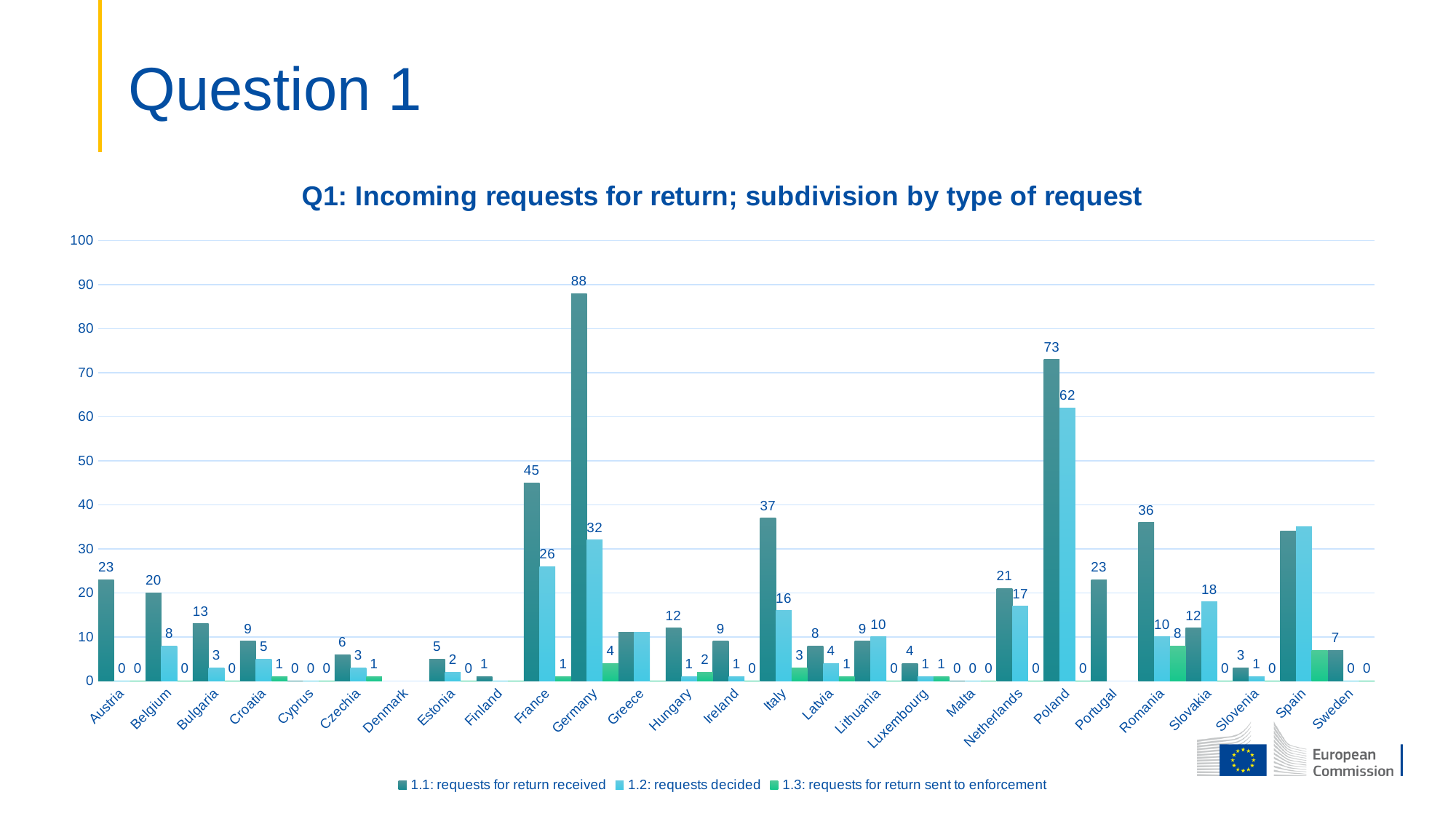
Which country has the highest value for '1.1: requests for return received'? Germany What is the value of '1.2: requests decided' for Poland? 62 Is the value of '1.1: requests for return received' for Spain greater or less than 30? greater Which is larger: '1.1: requests for return received' for France or for Italy? France What is the value of '1.3: requests for return sent to enforcement' for Romania? 8 What is the title of the chart? Q1: Incoming requests for return; subdivision by type of request What is the value of '1.1: requests for return received' for Germany? 88 What is the difference between '1.1: requests for return received' and '1.2: requests decided' for Poland? 11 How many series does the legend list? 3 How many countries are shown on the x axis? 27 What is the difference between the '1.1: requests for return received' values for Germany and France? 43 What kind of chart is shown on the slide? bar chart